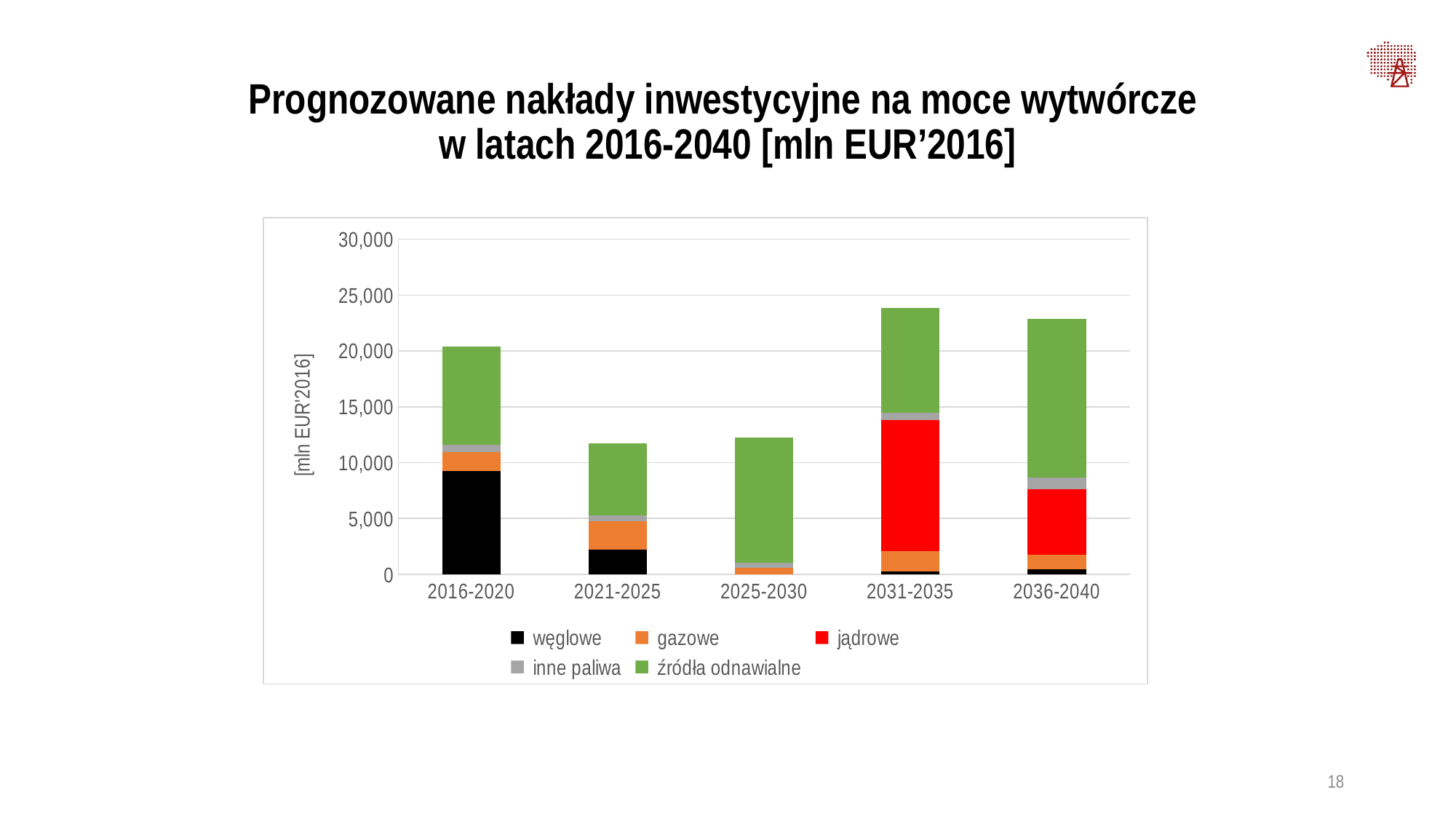
What kind of chart is shown on the slide? Stacked bar chart Is the total for 2031-2035 greater or less than 20,000? greater Is the total for 2021-2025 greater or less than 15,000? less How many series does the legend list? 5 How many time periods are shown on the x axis? 5 Which period has the larger total: 2025-2030 or 2036-2040? 2036-2040 Is the węglowe (coal) segment for 2016-2020 greater or less than 10,000? less Which period has the larger total: 2016-2020 or 2021-2025? 2016-2020 Which period has the highest total investment outlay? 2031-2035 What is the label on the y axis? [mln EUR'2016] Which colour represents jądrowe in the legend? Red